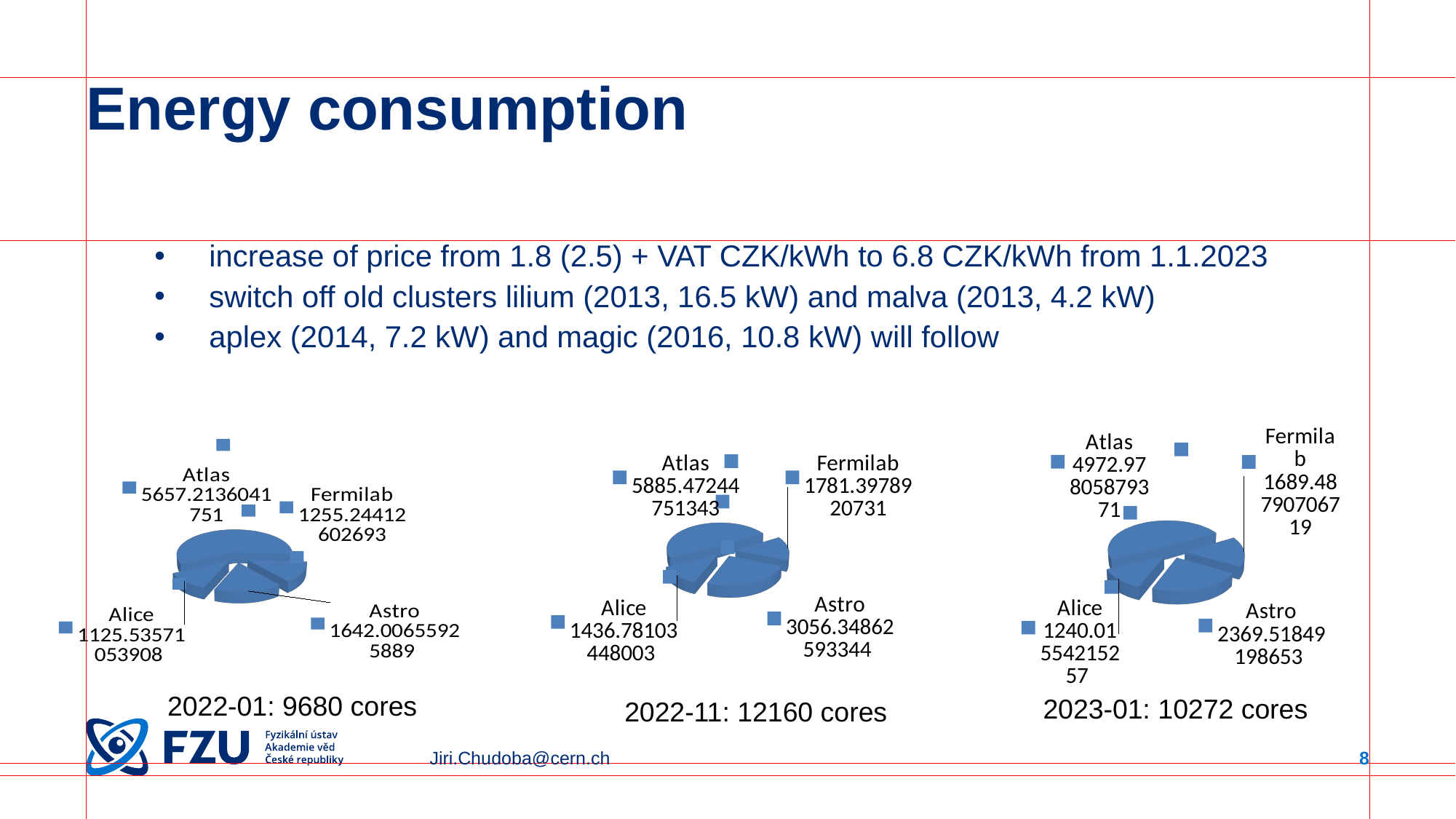
What kind of chart is used for the 2022-01 (9680 cores) chart? pie chart In the 2022-01 (9680 cores) chart, what is the value for Atlas? 5657.2136041751 In the 2023-01 (10272 cores) chart, what is the value for Alice? 1240.01554215257 What caption is shown under the middle pie chart? 2022-11: 12160 cores In the 2022-11 (12160 cores) chart, what is the value for Astro? 3056.34862593344 How many slices does the 2022-11 (12160 cores) pie chart have? 4 In the 2023-01 (10272 cores) chart, what is the value for Astro? 2369.51849198653 In the 2023-01 (10272 cores) chart, which category has the largest slice? Atlas In the 2022-11 (12160 cores) chart, which is larger, Astro or Fermilab? Astro In the 2022-11 (12160 cores) chart, what is the value for Fermilab? 1781.3978920731 In the 2022-01 (9680 cores) chart, what is the value for Alice? 1125.53571053908 In the 2022-01 (9680 cores) chart, which category has the smallest slice? Alice